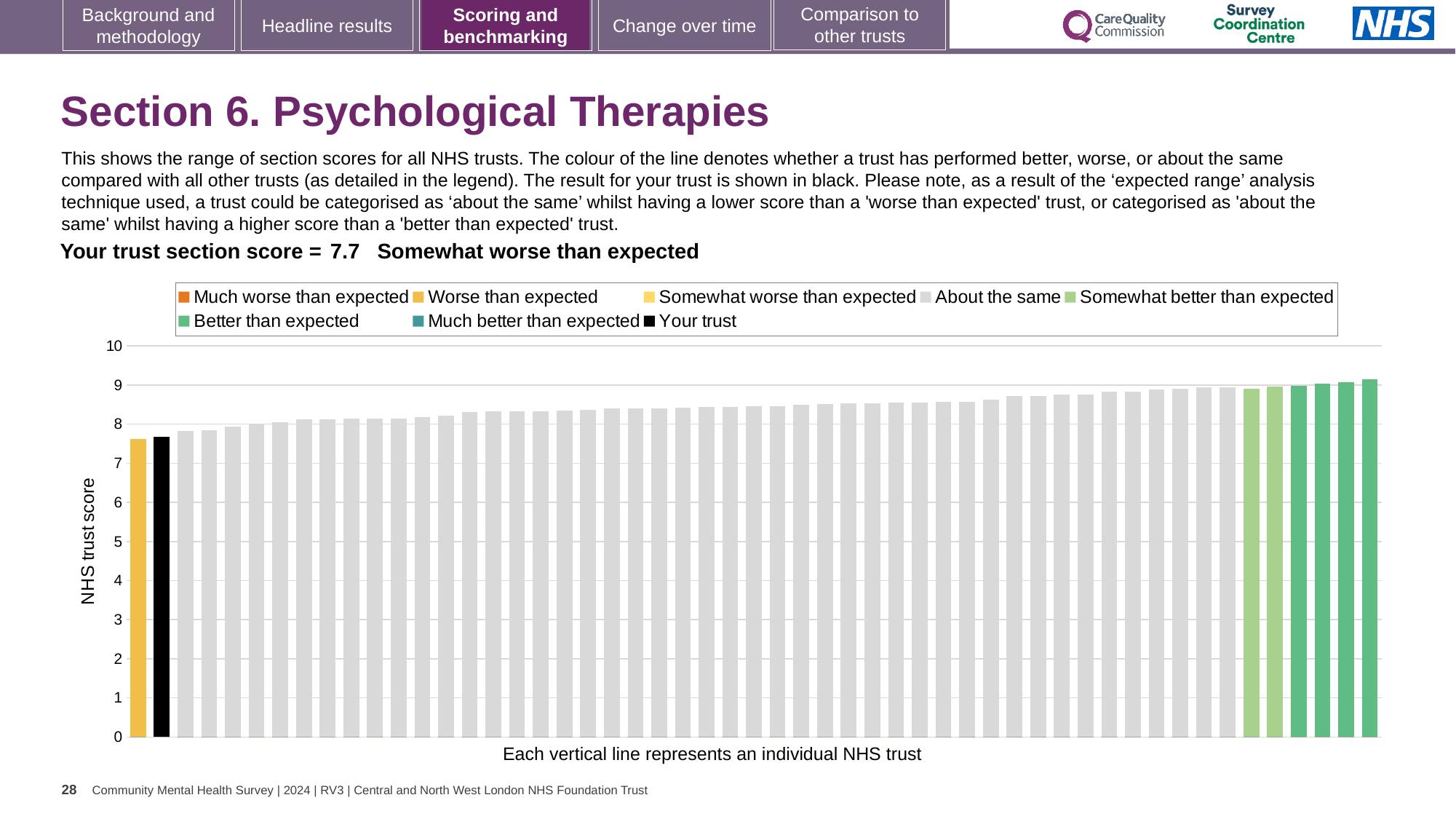
Is the value of the leftmost (yellow) bar greater or less than 7? greater What kind of chart is shown on the slide? bar chart Which is larger, the leftmost bar or the rightmost bar? the rightmost bar Is the value of the leftmost bar greater or less than 8? less Do the bar values rise or fall from left to right across the chart? rise What colour is the bar representing your trust? black Is the value of the black bar (your trust) greater or less than 5? greater Which performance category is your trust placed in for this section? Somewhat worse than expected What is the label on the vertical axis of the chart? NHS trust score How many entries does the chart legend list? 8 What is the section score for your trust shown on the slide? 7.7